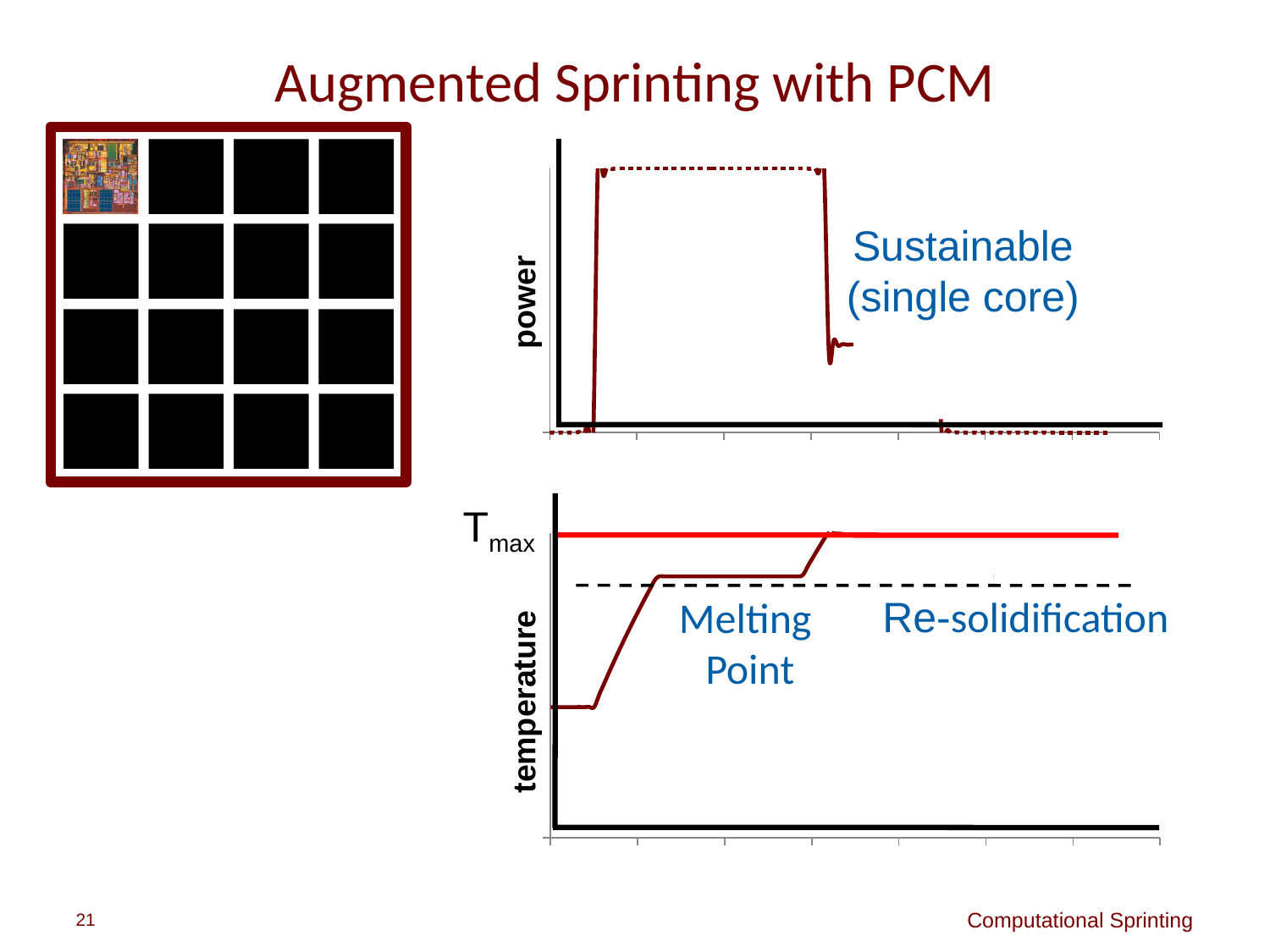
What kind of chart is the bottom chart on the slide? line chart What is the y-axis label of the top chart? power What is the y-axis label of the bottom chart? temperature In the top (power) chart, is the power level labelled Sustainable (single core) higher or lower than the initial plateau? lower In the bottom (temperature) chart, does the temperature rise or fall along the x axis after the initial flat segment? rise In the bottom (temperature) chart, is the dashed line labelled Melting Point above or below the red Tmax line? below In the top (power) chart, does the power rise or fall at the end of the high plateau? fall What kind of chart is the top chart on the slide? line chart